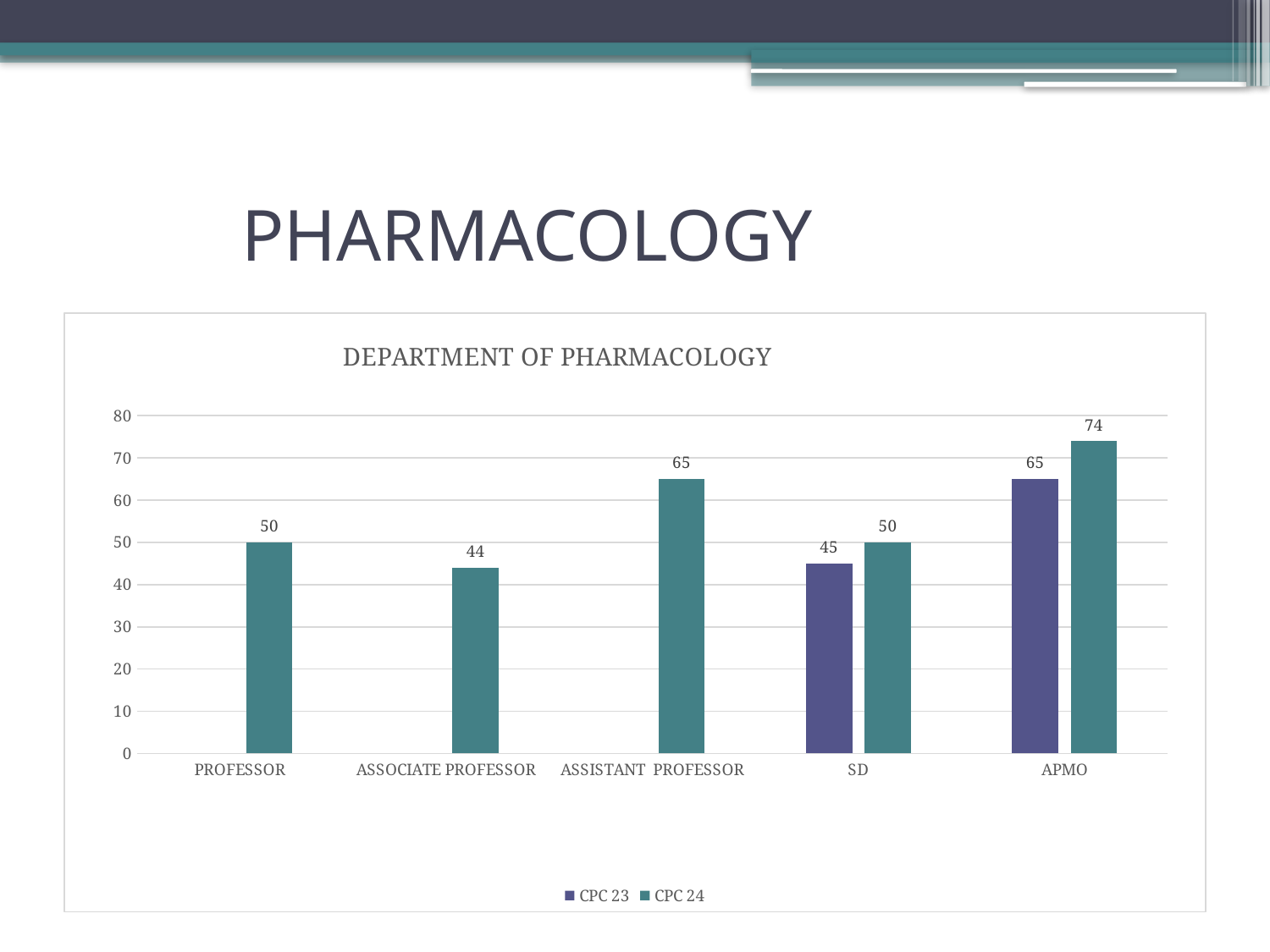
Which category has the lowest CPC 24 value? ASSOCIATE PROFESSOR What kind of chart is shown on the slide? Bar chart Is the CPC 24 value for ASSISTANT PROFESSOR greater or less than 60? greater What is the CPC 24 value for ASSOCIATE PROFESSOR? 44 How many categories are shown on the x axis? 5 How many series does the legend list? 2 What is the CPC 23 value for SD? 45 Which category has the highest CPC 24 value? APMO What is the CPC 24 value for APMO? 74 What is the title of the chart? DEPARTMENT OF PHARMACOLOGY For SD, which is larger: the CPC 23 value or the CPC 24 value? CPC 24 What is the difference between the CPC 24 and CPC 23 values for APMO? 9